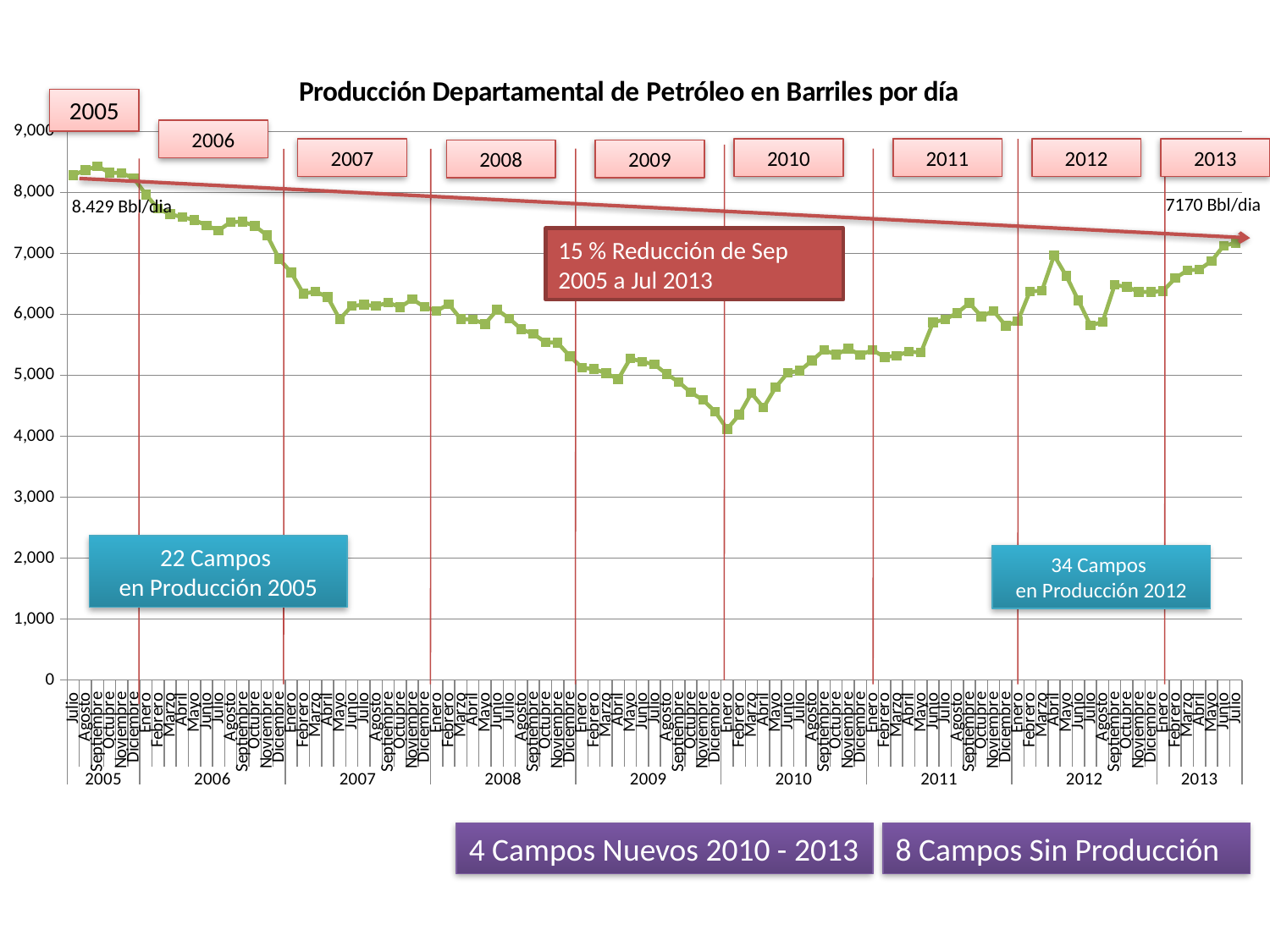
How many years are labelled along the x axis? 9 Does the line generally rise or fall from Enero 2010 to Julio 2013? rise Is the value for Enero 2010 greater or less than 5,000? less What is the title of the chart? Producción Departamental de Petróleo en Barriles por día Which is larger, the value for Julio 2005 or the value for Julio 2013? Julio 2005 What kind of chart is shown on the slide? line chart Is the value for Enero 2011 greater or less than 5,000? greater Does the line generally rise or fall from Julio 2005 to Enero 2010? fall Is the value for Enero 2013 greater or less than 6,000? greater What production value is labelled at the start of the series in 2005? 8.429 Bbl/dia What production value is labelled at the end of the series in 2013? 7170 Bbl/dia